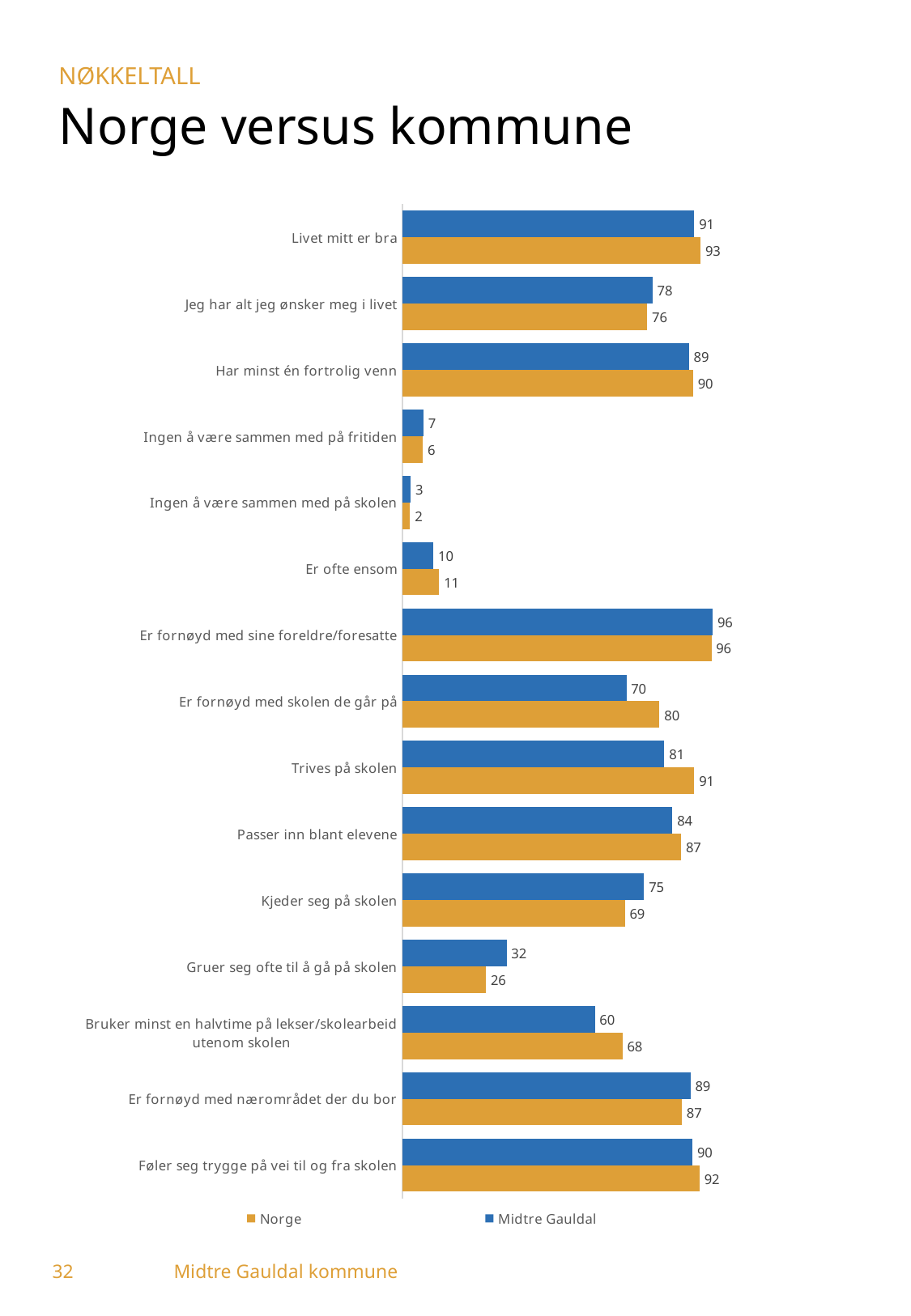
What kind of chart is shown on the slide? Bar chart What is the value for Midtre Gauldal for "Er fornøyd med skolen de går på"? 70 What is the difference between Norge and Midtre Gauldal for "Bruker minst en halvtime på lekser/skolearbeid utenom skolen"? 8 What is the value for Midtre Gauldal for "Gruer seg ofte til å gå på skolen"? 32 Which colour represents Midtre Gauldal in the chart? Blue How many categories are shown on the chart? 15 How many series does the legend list? 2 Which is larger for "Kjeder seg på skolen": Norge or Midtre Gauldal? Midtre Gauldal What is the value for Norge for "Trives på skolen"? 91 Which is larger for "Er fornøyd med skolen de går på": Norge or Midtre Gauldal? Norge Which category has the lowest value for Midtre Gauldal? Ingen å være sammen med på skolen Which category has the highest value for Norge? Er fornøyd med sine foreldre/foresatte